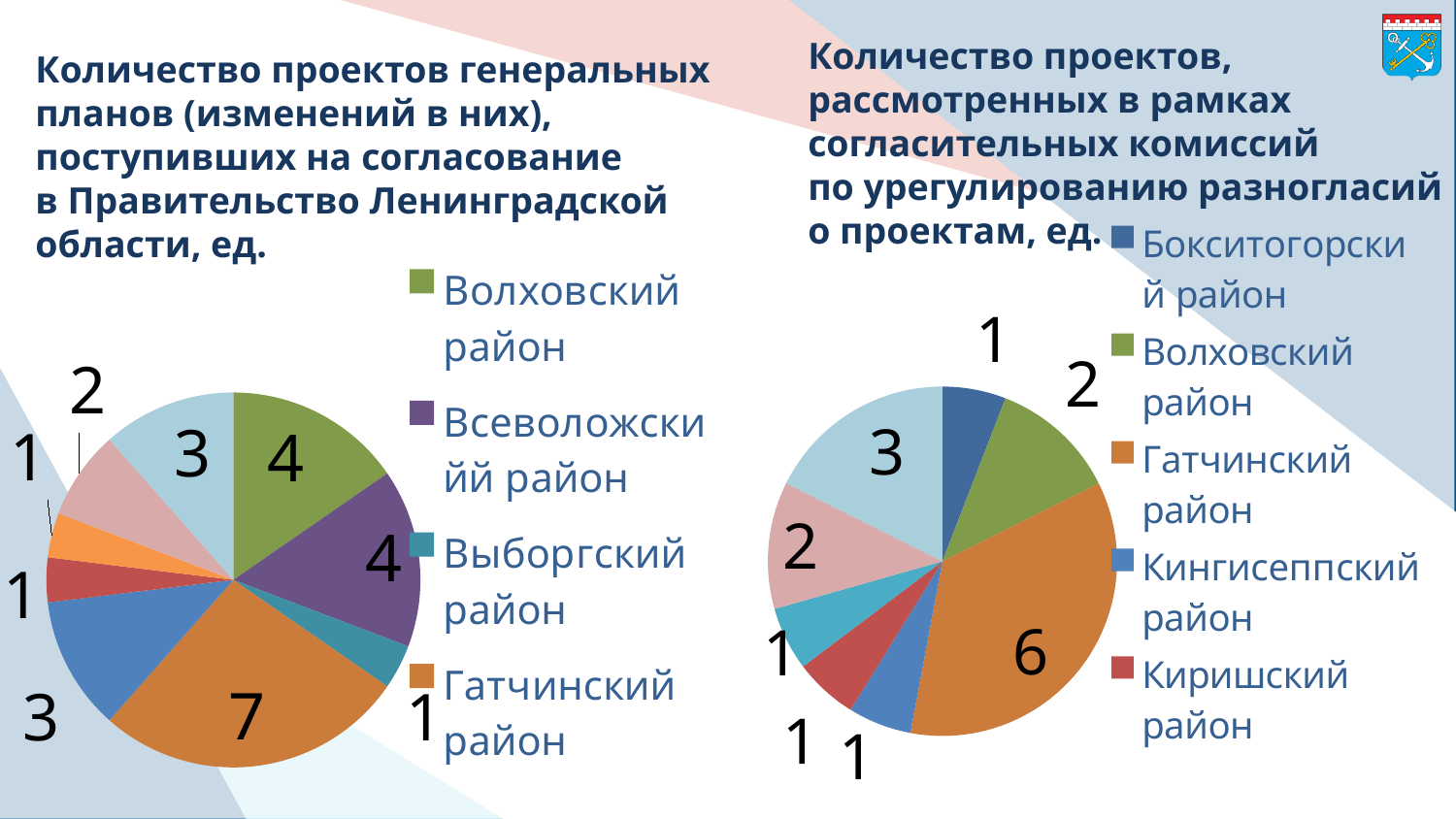
In the left chart, 'Количество проектов генеральных планов...', what is the difference between the values for Гатчинский район and Волховский район? 3 In the left chart, 'Количество проектов генеральных планов...', what is the value for Волховский район? 4 In the left chart, 'Количество проектов генеральных планов...', which is larger: Всеволожский район or Выборгский район? Всеволожский район In the right chart, 'Количество проектов, рассмотренных в рамках согласительных комиссий...', what is the value for Гатчинский район? 6 In the left chart, 'Количество проектов генеральных планов...', how many slices does the pie have? 9 In the right chart, 'Количество проектов, рассмотренных в рамках согласительных комиссий...', how many entries does the legend list? 5 What kind of chart is the left chart, 'Количество проектов генеральных планов...'? pie chart In the right chart, 'Количество проектов, рассмотренных в рамках согласительных комиссий...', what is the value for Волховский район? 2 In the right chart, 'Количество проектов, рассмотренных в рамках согласительных комиссий...', which district has the largest slice? Гатчинский район In the left chart, 'Количество проектов генеральных планов...', which district has the largest slice? Гатчинский район In the left chart, 'Количество проектов генеральных планов...', what is the value for Гатчинский район? 7 In the left chart, 'Количество проектов генеральных планов...', what is the value for Выборгский район? 1